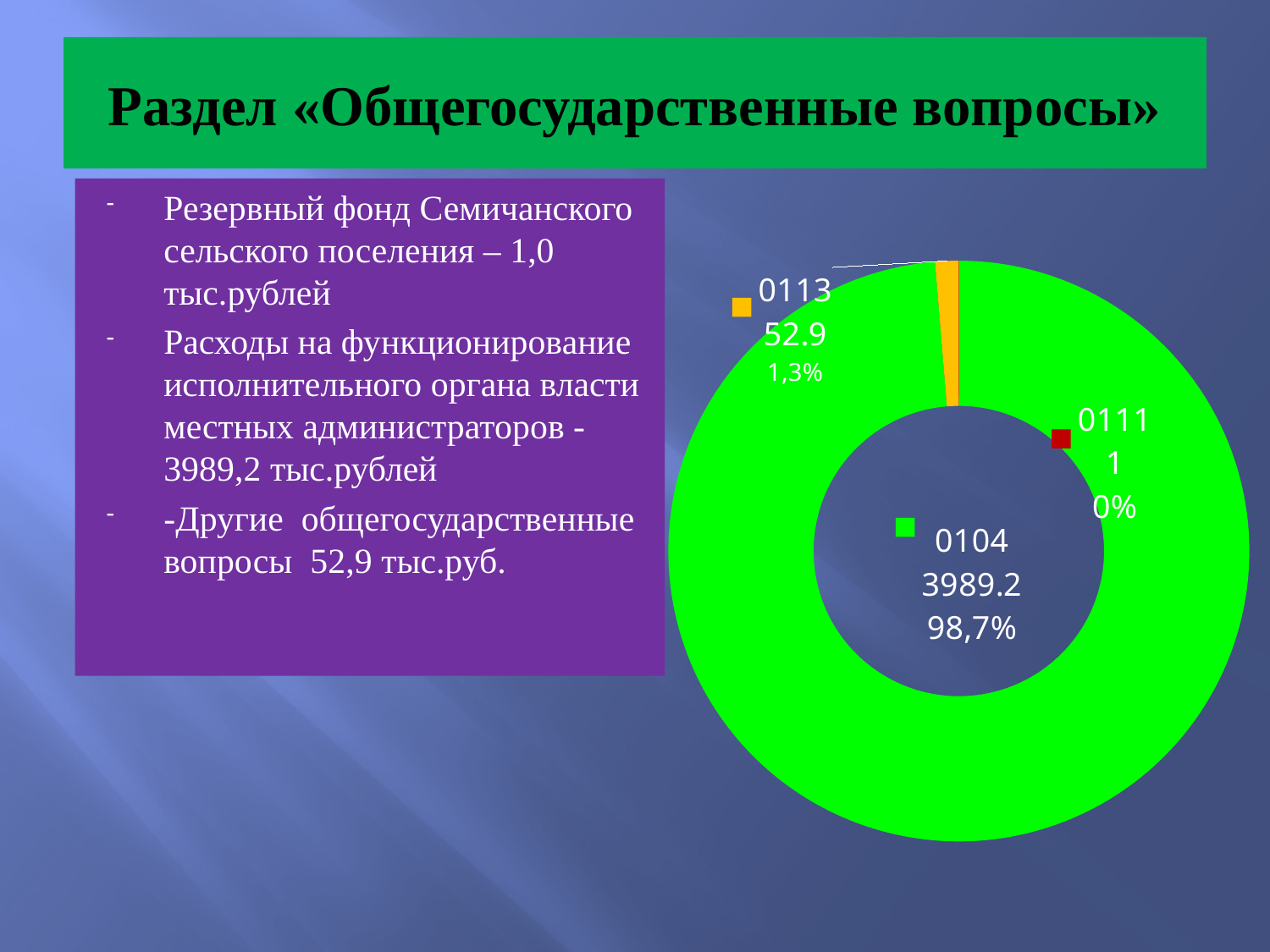
What percentage share does category 0104 have in the chart? 98,7% What kind of chart is shown on the slide? doughnut chart What percentage share does category 0111 have in the chart? 0% Which category has the smallest value in the chart? 0111 What value is shown for category 0113 in the chart? 52.9 What value is shown for category 0111 in the chart? 1 What value is shown for category 0104 in the chart? 3989.2 How many categories are shown in the chart? 3 What percentage share does category 0113 have in the chart? 1,3% Which is larger, the value for 0113 or the value for 0111? 0113 What is the difference between the values for 0104 and 0113? 3936.3 Which category has the largest value in the chart? 0104